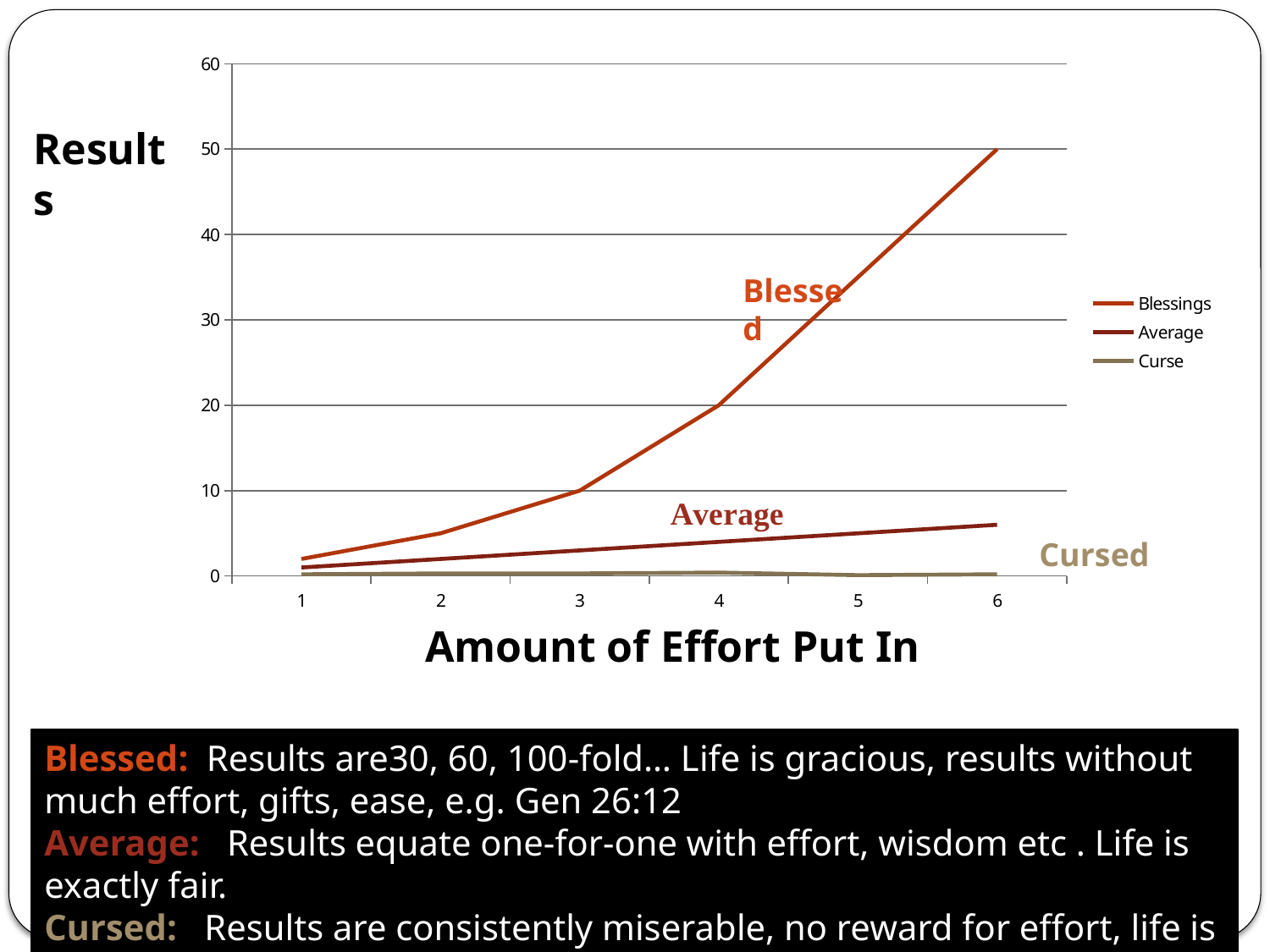
What type of chart is shown on the slide? line chart Is the value of the Average line at effort level 6 greater or less than 10? less Which series has the lowest values across the chart? Curse What is the value of the Blessings line at effort level 4? 20 Is the value of the Blessings line at effort level 5 greater or less than 30? greater What is the title of the x axis? Amount of Effort Put In What is the value of the Blessings line at effort level 6? 50 How many points are on the x axis (Amount of Effort Put In)? 6 What is the value of the Blessings line at effort level 3? 10 How many series does the legend list? 3 Which series has the highest value at effort level 6? Blessings Does the Blessings line rise or fall as the amount of effort increases? rises